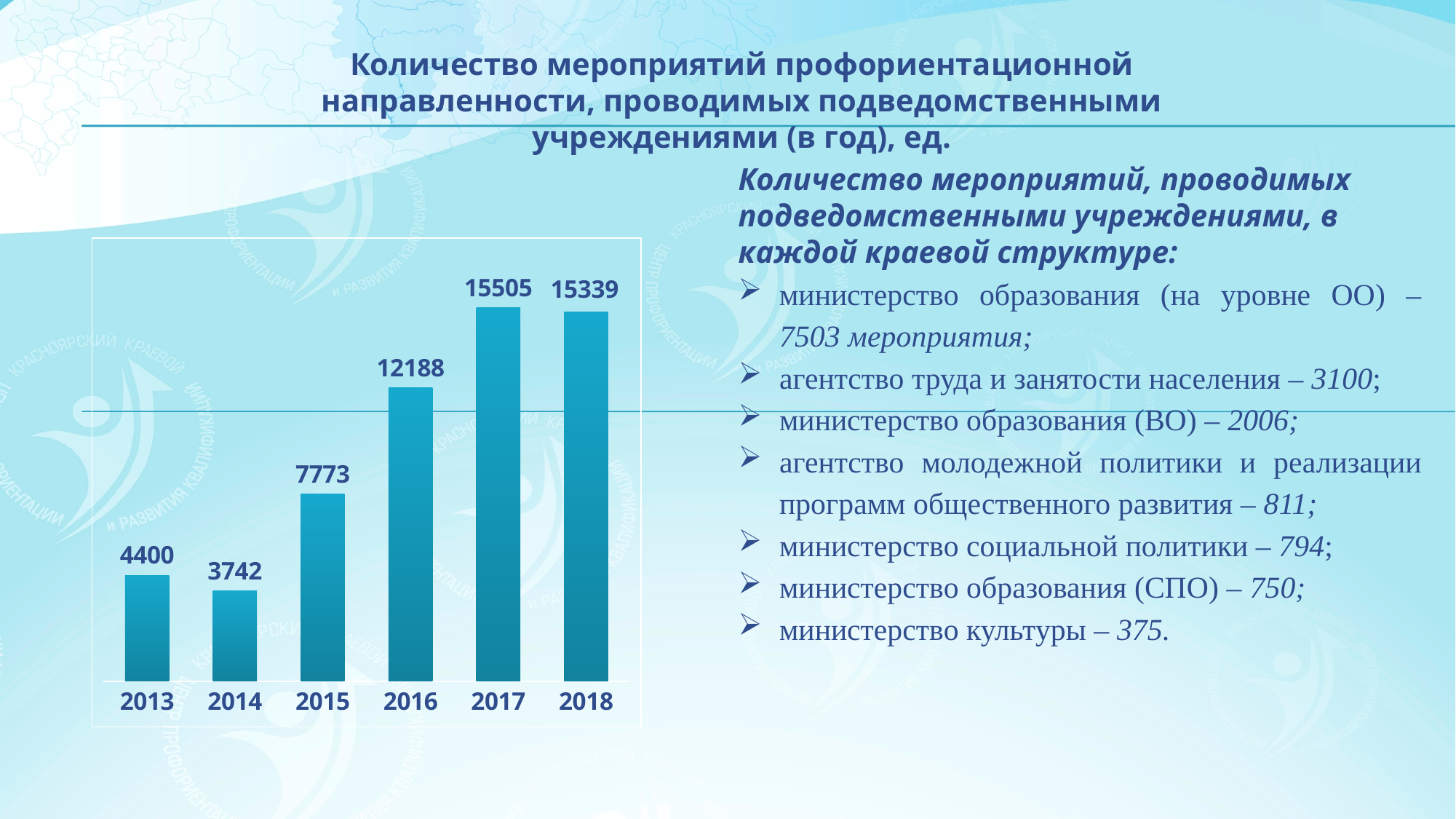
What kind of chart is shown on the slide? bar chart Which year has the highest value? 2017 What is the value for 2018? 15339 Do the values generally rise or fall from 2014 to 2017? rise What is the difference between the values for 2017 and 2018? 166 Which year has the lowest value? 2014 What is the value for 2013? 4400 What is the first year shown on the x axis? 2013 How many years are shown on the x axis? 6 What is the difference between the values for 2016 and 2015? 4415 What is the value for 2016? 12188 Which is larger, the value for 2013 or the value for 2014? 2013